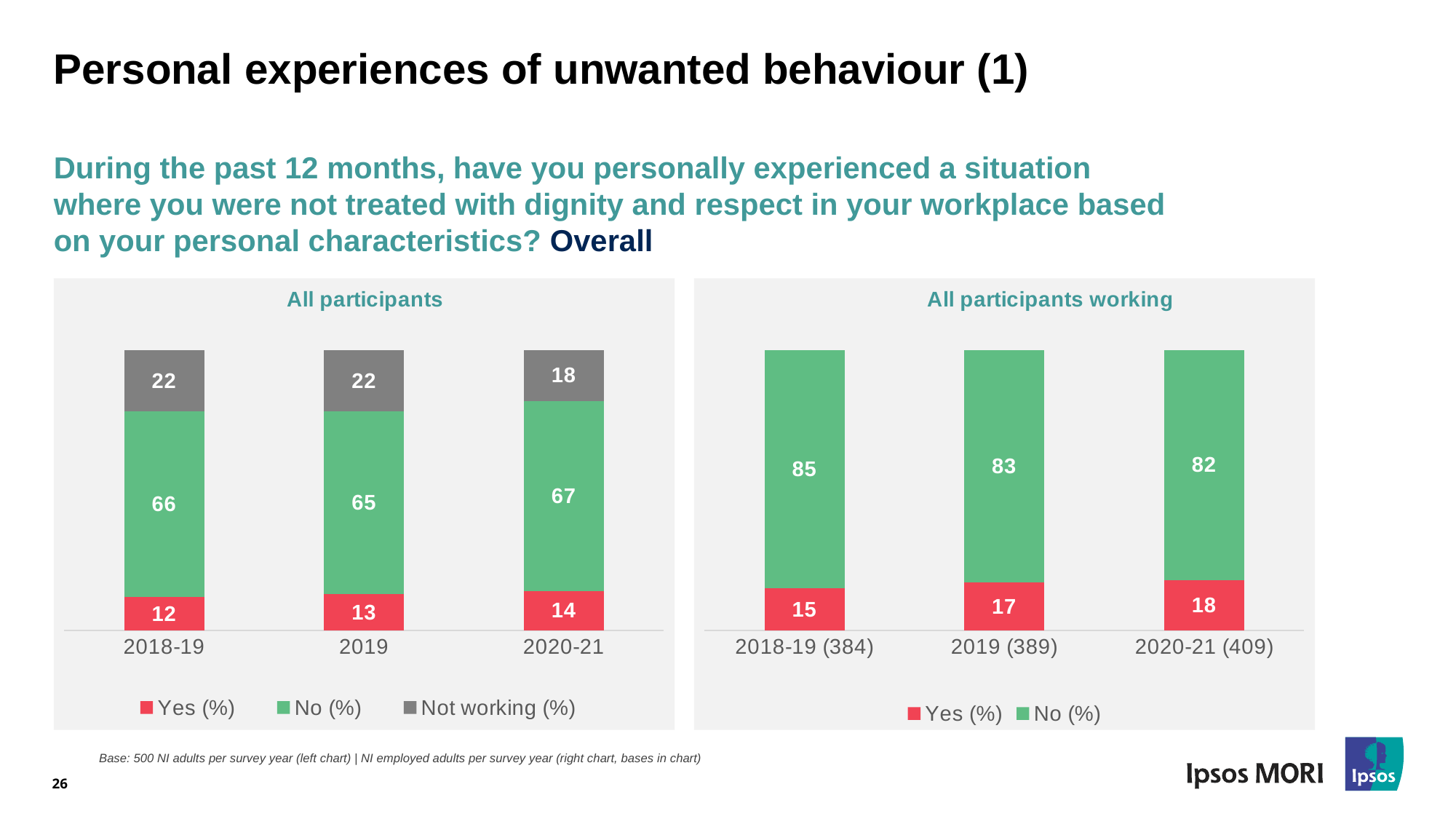
In the 'All participants working' chart, what is the difference between the 'No (%)' values for 2018-19 (384) and 2020-21 (409)? 3 How many series does the legend of the 'All participants' chart list? 3 In the 'All participants' chart, is the 'Yes (%)' value larger for 2018-19 or 2020-21? 2020-21 In the 'All participants working' chart, what is the 'No (%)' value for 2019 (389)? 83 In the 'All participants working' chart, do the 'Yes (%)' values rise or fall from 2018-19 (384) to 2020-21 (409)? Rise In the 'All participants working' chart, which year has the highest 'Yes (%)' value? 2020-21 (409) In the 'All participants' chart, what is the 'Yes (%)' value for 2018-19? 12 What kind of chart is the 'All participants working' chart? Stacked bar chart In the 'All participants' chart, what is the total of the stacked bar for 2019? 100 How many categories are shown on the x axis of the 'All participants working' chart? 3 In the 'All participants' chart, which year has the lowest 'No (%)' value? 2019 In the 'All participants' chart, what is the 'Not working (%)' value for 2020-21? 18